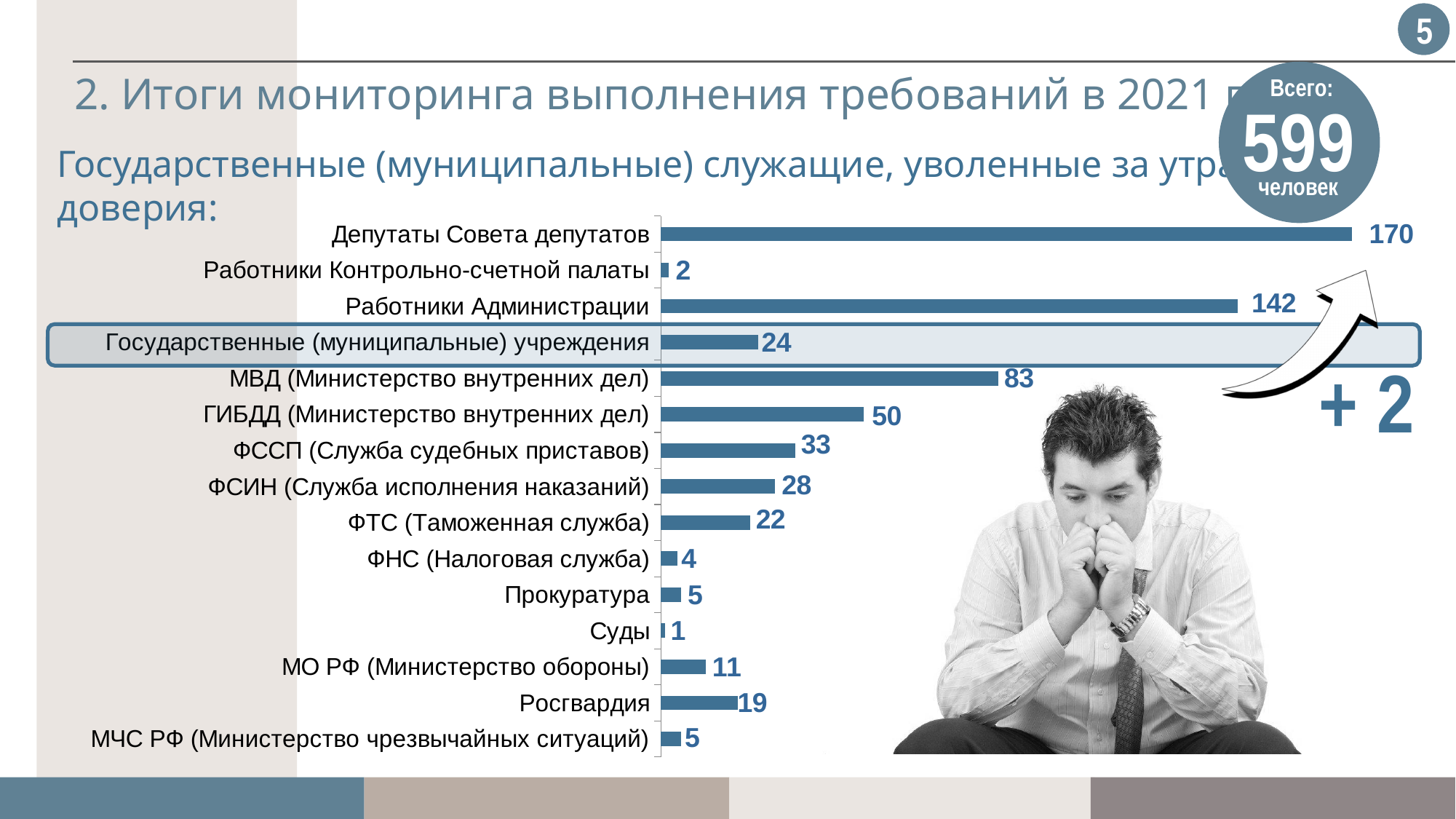
Which category has the highest value? Депутаты Совета депутатов What is the value for Депутаты Совета депутатов? 170 What is the difference between the values for ФССП (Служба судебных приставов) and ФСИН (Служба исполнения наказаний)? 5 What is the value for Работники Администрации? 142 Which category has the lowest value? Суды How many categories are plotted in the bar chart? 15 What is the value for ГИБДД (Министерство внутренних дел)? 50 What is the value for Росгвардия? 19 What type of chart is shown on the slide? bar chart What is the difference between the values for Депутаты Совета депутатов and Работники Администрации? 28 Which is larger, the value for МВД (Министерство внутренних дел) or the value for ГИБДД (Министерство внутренних дел)? МВД (Министерство внутренних дел) What total number of people is shown in the circle at the top right of the slide? 599